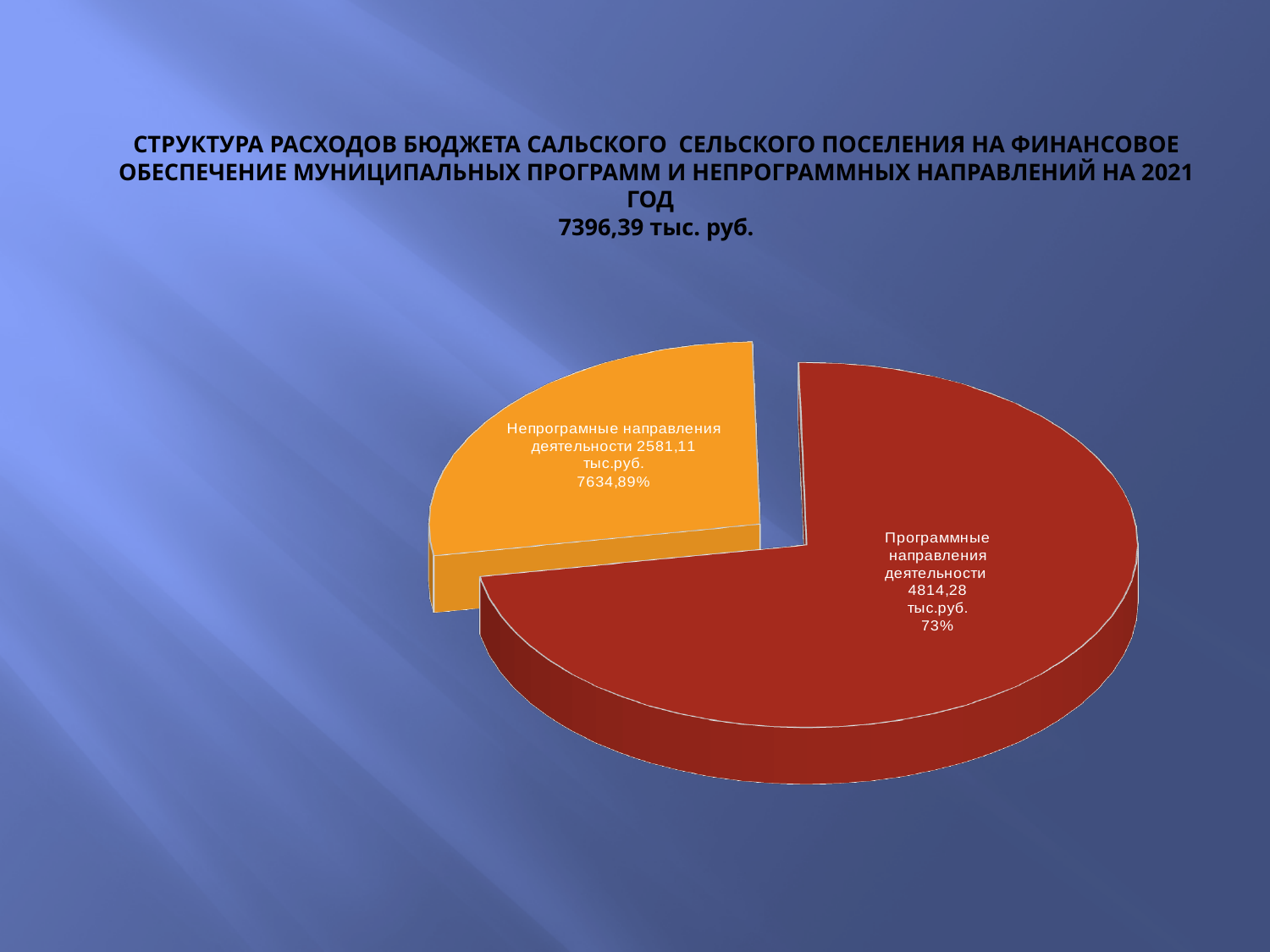
What kind of chart is shown on the slide? Pie chart What percentage label is printed on the Непрограмные направления деятельности slice? 7634,89% How many slices does the pie chart have? 2 What total amount is stated in the chart title? 7396,39 тыс. руб. What value is shown for Программные направления деятельности? 4814,28 тыс.руб. Which slice of the pie is the largest? Программные направления деятельности What is the difference between the values for Программные направления деятельности and Непрограмные направления деятельности? 2233,17 тыс.руб. Which is larger: Программные направления деятельности or Непрограмные направления деятельности? Программные направления деятельности What share of the pie does Программные направления деятельности take? 73% What value is shown for Непрограмные направления деятельности? 2581,11 тыс.руб. What colour is the Непрограмные направления деятельности slice? Orange Which slice of the pie is the smallest? Непрограмные направления деятельности